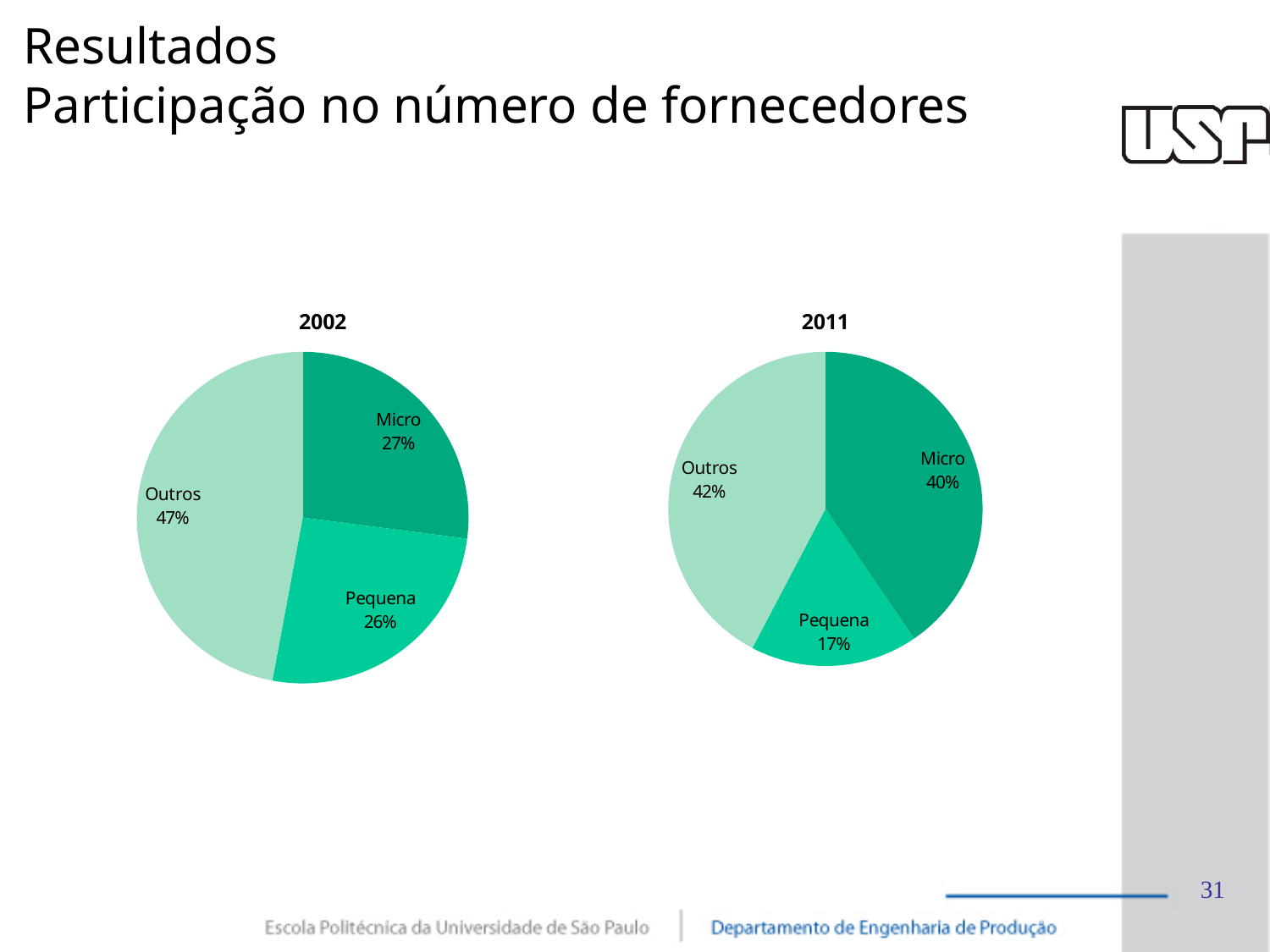
In the 2002 chart, what share does Outros have? 47% In the 2002 chart, which category has the largest slice? Outros In the 2011 chart, what share does Pequena have? 17% In the 2002 chart, what share does Micro have? 27% In the 2011 chart, which category has the smallest slice? Pequena What is the difference between the Micro share in 2011 and the Micro share in 2002? 13% What kind of chart is the 2011 chart? Pie chart How many slices does the 2002 chart have? 3 In the 2011 chart, what share does Micro have? 40% In the 2011 chart, which is larger, Outros or Micro? Outros What is the title of the chart on the left? 2002 In the 2011 chart, what is the difference between the Outros and Micro shares? 2%